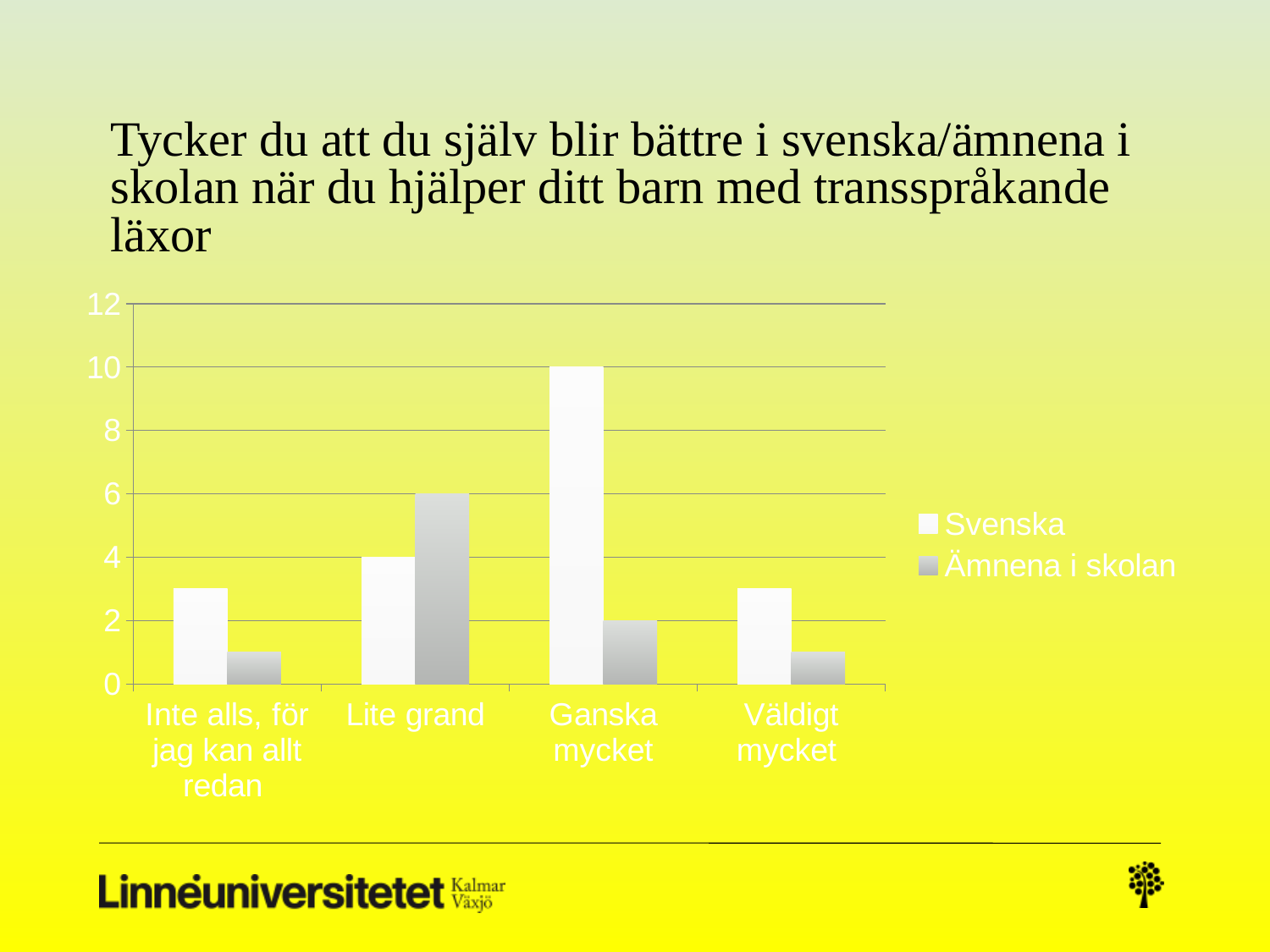
In the category Lite grand, which series has the larger value, Svenska or Ämnena i skolan? Ämnena i skolan What is the value for Svenska in the category Ganska mycket? 10 What is the value for Svenska in the category Lite grand? 4 How many categories are shown on the x axis? 4 What is the value for Ämnena i skolan in the category Lite grand? 6 Is the value for Svenska in the category Väldigt mycket greater or less than 4? less Which category has the highest value for Svenska? Ganska mycket What kind of chart is shown on the slide? bar chart How many series does the legend list? 2 Which category has the highest value for Ämnena i skolan? Lite grand Is the value for Ämnena i skolan in the category Inte alls, för jag kan allt redan greater or less than 2? less What is the value for Ämnena i skolan in the category Ganska mycket? 2